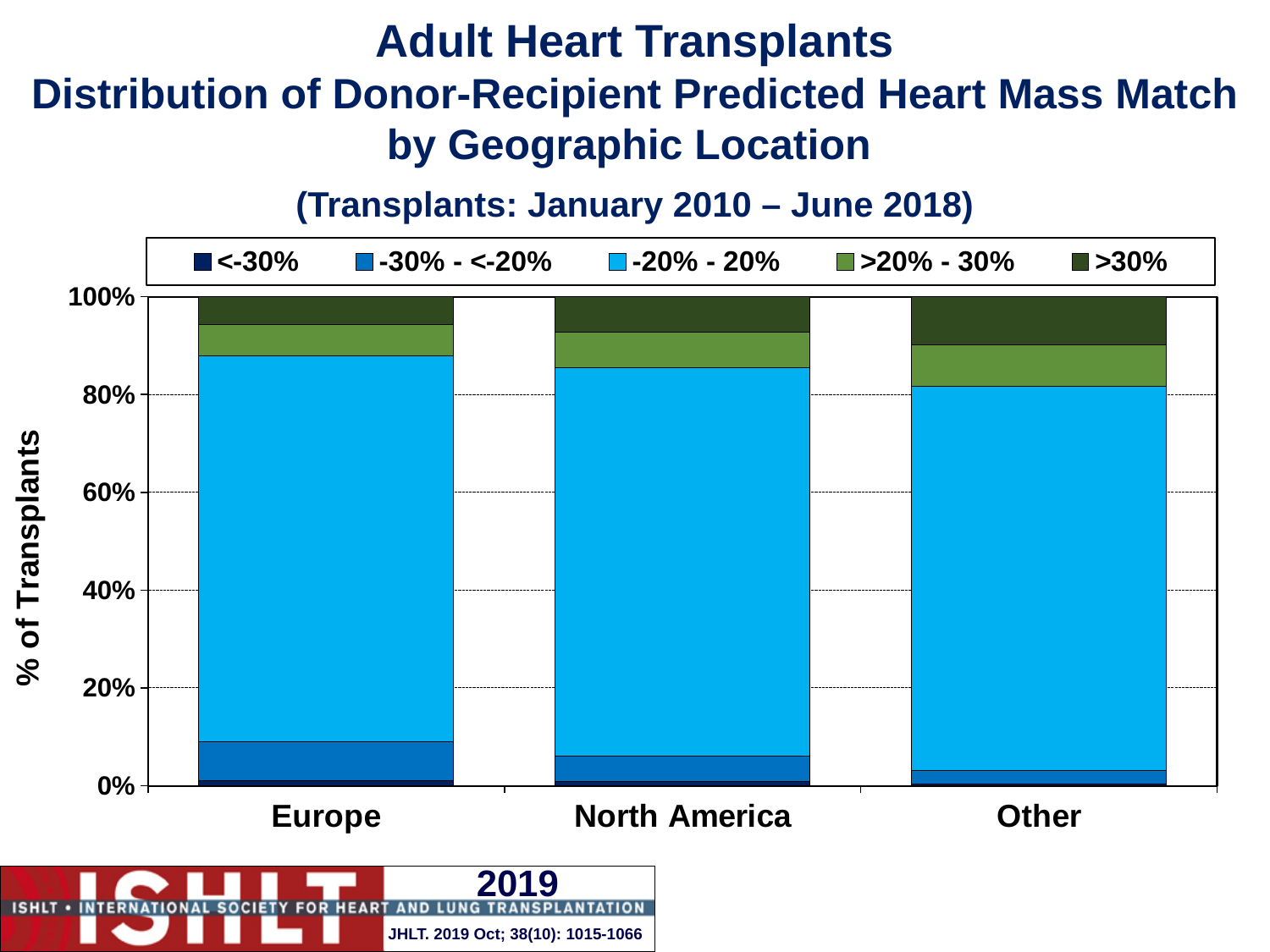
How many geographic locations are shown on the x axis? 3 Which geographic location has the smallest share in the -30% - <-20% category? Other Which has the larger share in the >30% category, Europe or Other? Other What kind of chart is shown on the slide? Stacked bar chart Is the share of the -30% - <-20% category for North America greater or less than 20%? less What time period of transplants does the chart cover, according to the subtitle? January 2010 – June 2018 What is the label of the y axis? % of Transplants Is the share of the >30% category for Other greater or less than 20%? less How many series does the legend list? 5 Is the share of the -20% - 20% category for Europe greater or less than 60%? greater Which geographic location has the largest share in the -30% - <-20% category? Europe Moving from Europe to North America to Other, does the share of the -30% - <-20% category rise or fall? fall